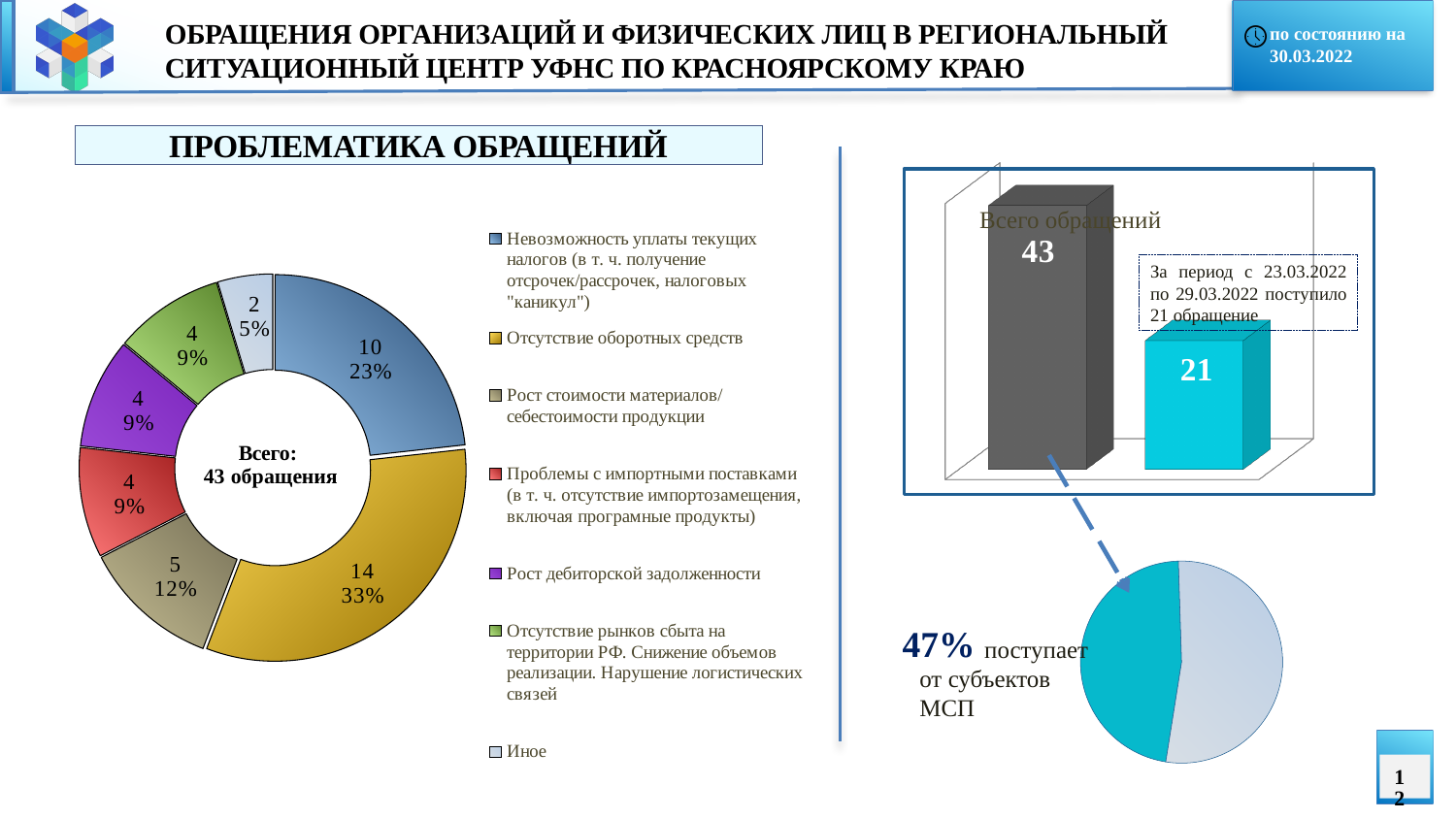
On the doughnut chart under "Проблематика обращений", what is the value for "Отсутствие оборотных средств"? 14 On the doughnut chart under "Проблематика обращений", which category has the largest value? Отсутствие оборотных средств On the bar chart titled "Всего обращений" on the right, what is the value of the taller bar? 43 On the doughnut chart under "Проблематика обращений", what is the difference between the values for "Отсутствие оборотных средств" and "Невозможность уплаты текущих налогов"? 4 On the doughnut chart under "Проблематика обращений", which category has the smallest value? Иное On the doughnut chart under "Проблематика обращений", what is the value for "Рост стоимости материалов/себестоимости продукции"? 5 What kind of chart is the "Всего обращений" chart on the right of the slide? Bar chart On the doughnut chart under "Проблематика обращений", what percentage share is shown for "Невозможность уплаты текущих налогов"? 23% On the doughnut chart under "Проблематика обращений", how many categories does the legend list? 7 On the pie chart at the bottom right, what share is shown for appeals from subjects of МСП? 47% On the doughnut chart under "Проблематика обращений", what total number of appeals is shown in the centre? 43 обращения On the bar chart titled "Всего обращений" on the right, what is the difference between the two bars? 22